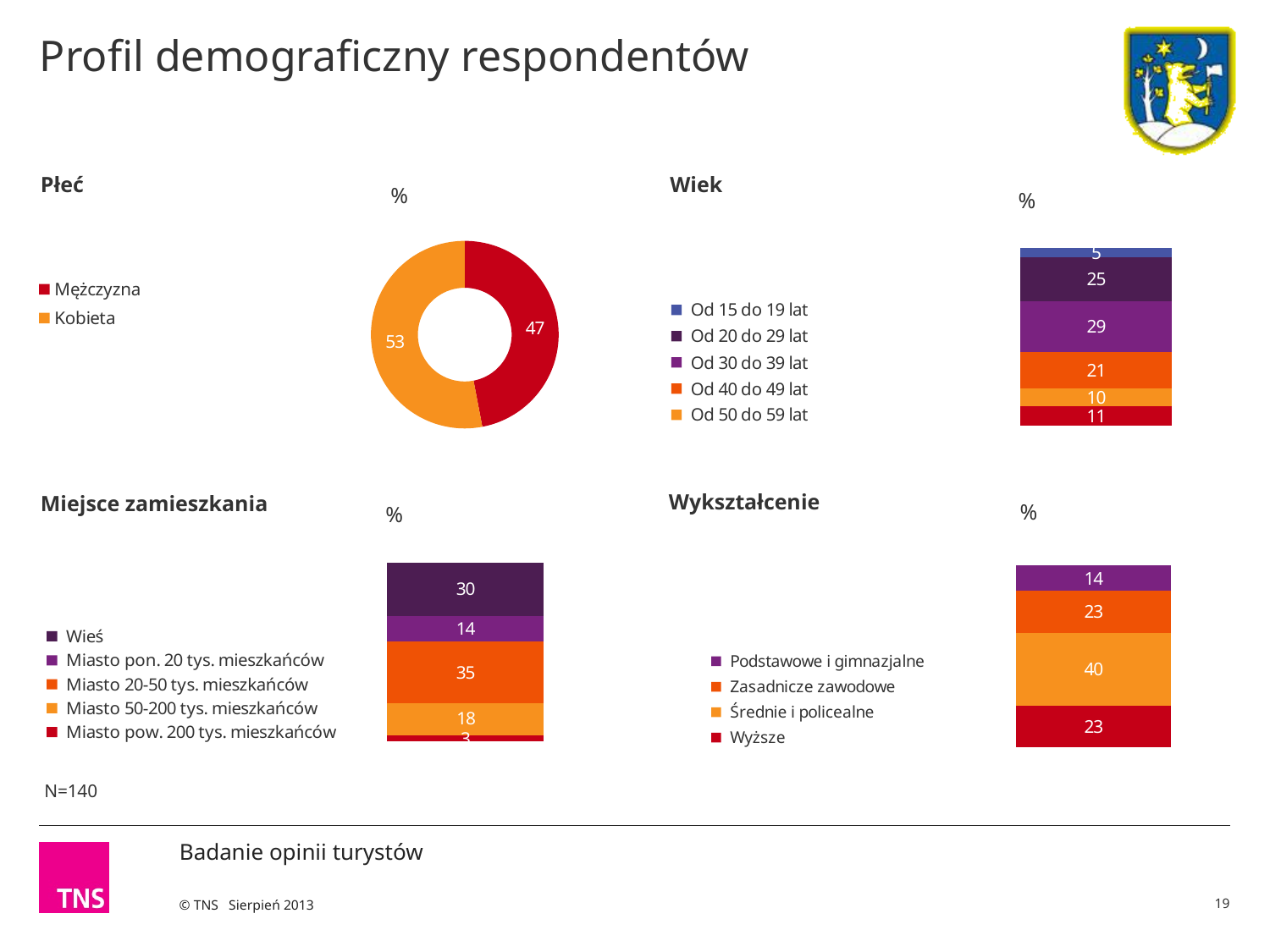
What kind of chart is the Płeć chart? Donut (pie) chart In the Płeć chart, which group is larger, Mężczyzna or Kobieta? Kobieta In the Wiek chart, what is the difference between Od 20 do 29 lat and Od 40 do 49 lat? 4 In the Płeć chart, what percentage of respondents are Kobieta? 53 In the Wiek chart, what is the value for Od 15 do 19 lat? 5 In the Płeć chart, what percentage of respondents are Mężczyzna? 47 In the Miejsce zamieszkania chart, what is the value for Wieś? 30 In the Miejsce zamieszkania chart, which category has the highest value? Miasto 20-50 tys. mieszkańców In the Wykształcenie chart, what is the total of the stacked bar? 100 How many entries does the legend of the Wiek chart list? 5 In the Wykształcenie chart, what is the value for Średnie i policealne? 40 In the Wiek chart, what is the value for Od 30 do 39 lat? 29